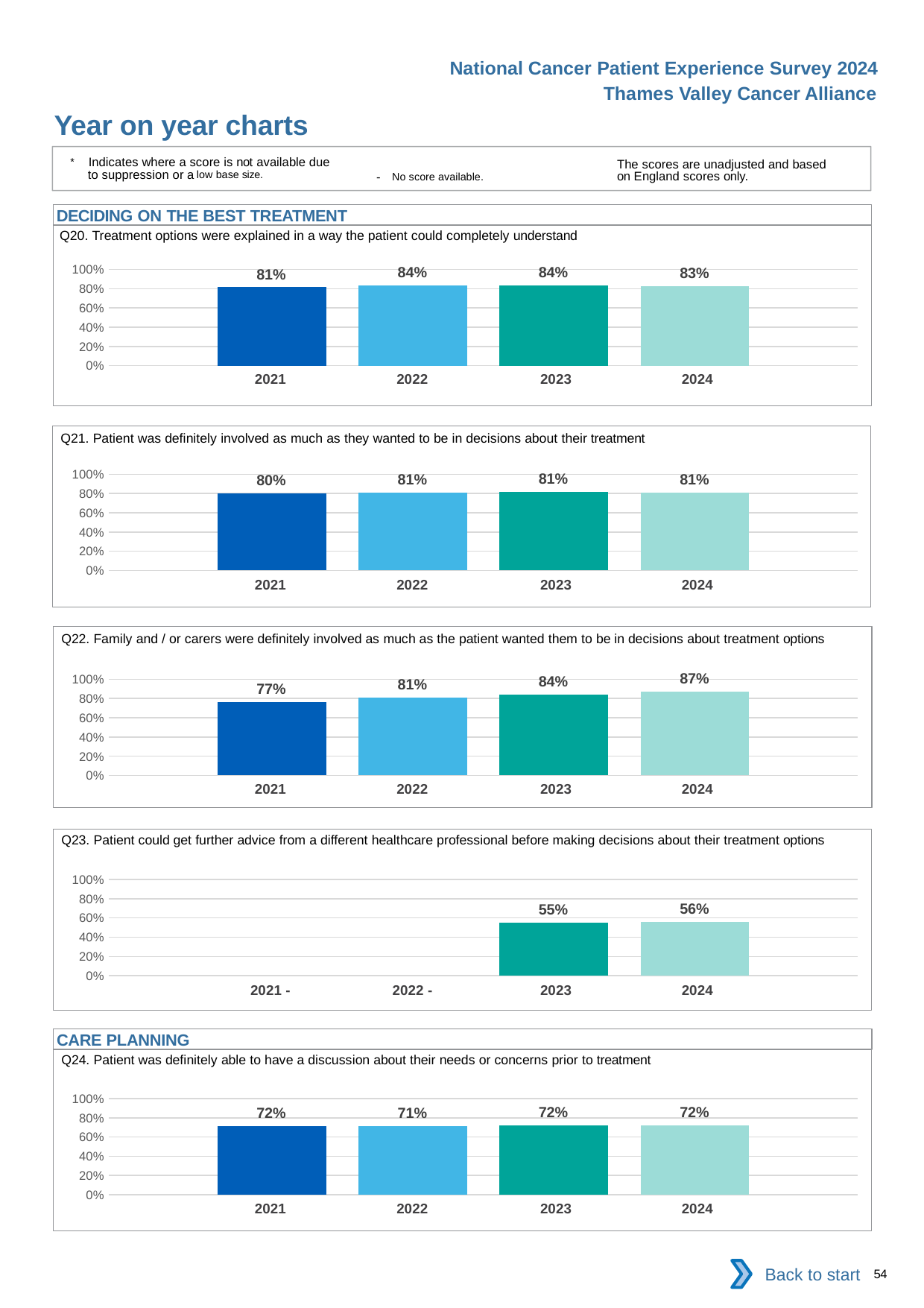
In the Q24 chart, is the value for 2023 greater or less than 80%? less In the Q24 chart (Patient was definitely able to have a discussion about their needs or concerns prior to treatment), what is the value for 2022? 71% In the Q21 chart (Patient was definitely involved as much as they wanted to be in decisions about their treatment), what is the value for 2024? 81% In the Q21 chart, which year has the lowest value? 2021 In the Q20 chart (Treatment options were explained in a way the patient could completely understand), what is the value for 2021? 81% In the Q23 chart (Patient could get further advice from a different healthcare professional before making decisions about their treatment options), what is the value for 2023? 55% In the Q22 chart, do the values rise or fall from 2021 to 2024? rise In the Q23 chart, how many years have a bar plotted? 2 What kind of chart is the Q20 chart? bar chart In the Q20 chart, what is the difference between the 2022 value and the 2021 value? 3% In the Q22 chart, what is the difference between the 2024 value and the 2021 value? 10% In the Q22 chart (Family and / or carers were definitely involved as much as the patient wanted them to be in decisions about treatment options), which year has the highest value? 2024